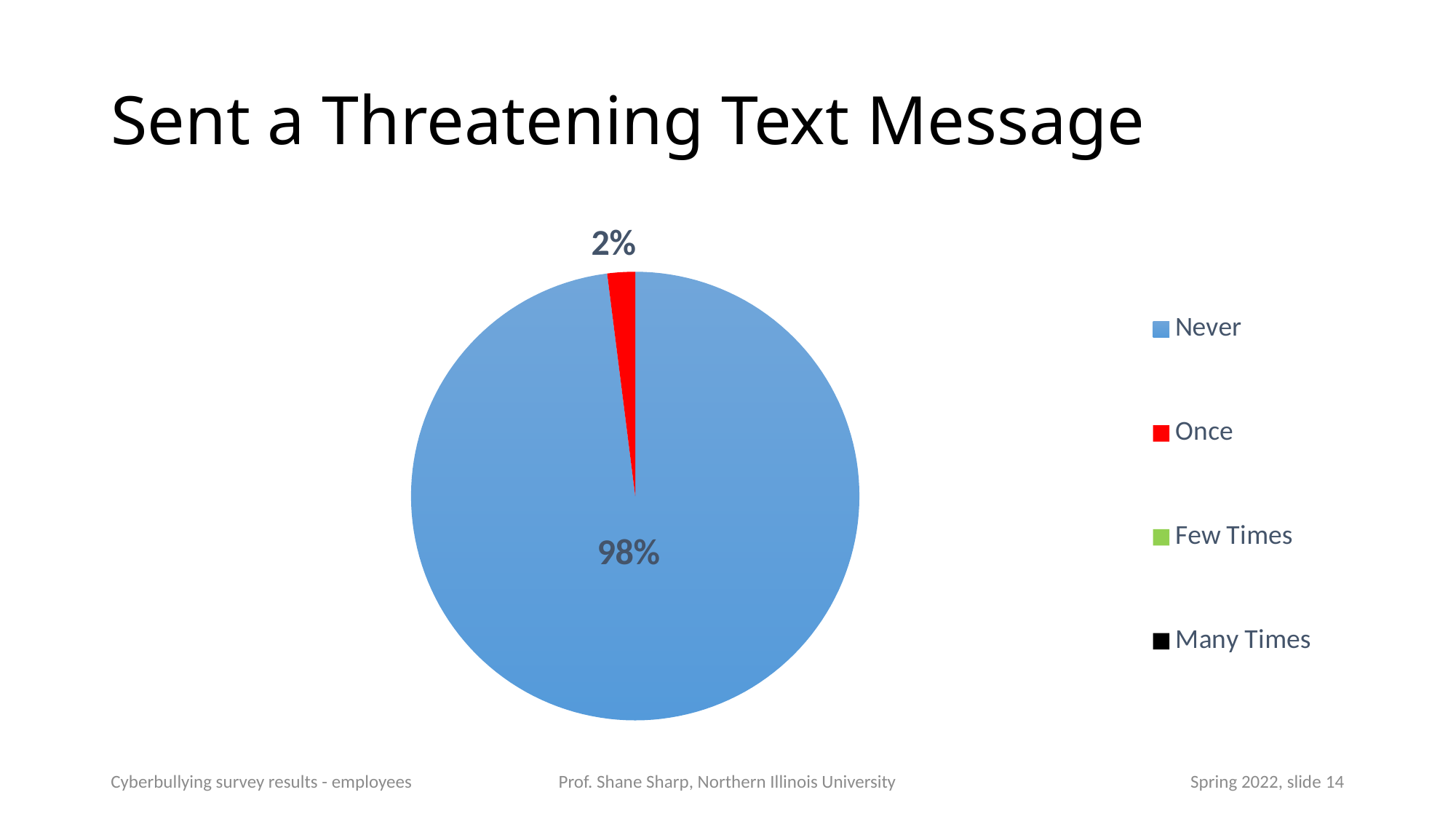
What percentage of respondents answered "Once"? 2% Which of the two labelled slices is larger, "Never" or "Once"? Never What percentage of respondents answered "Never"? 98% What is the title of the chart? Sent a Threatening Text Message Is the share for "Never" greater or less than 90%? greater Which category has the largest share of the pie? Never What kind of chart is shown on the slide? pie chart What colour is the "Once" slice? red What is the difference in percentage points between the "Never" and "Once" slices? 96 How many categories does the legend list? 4